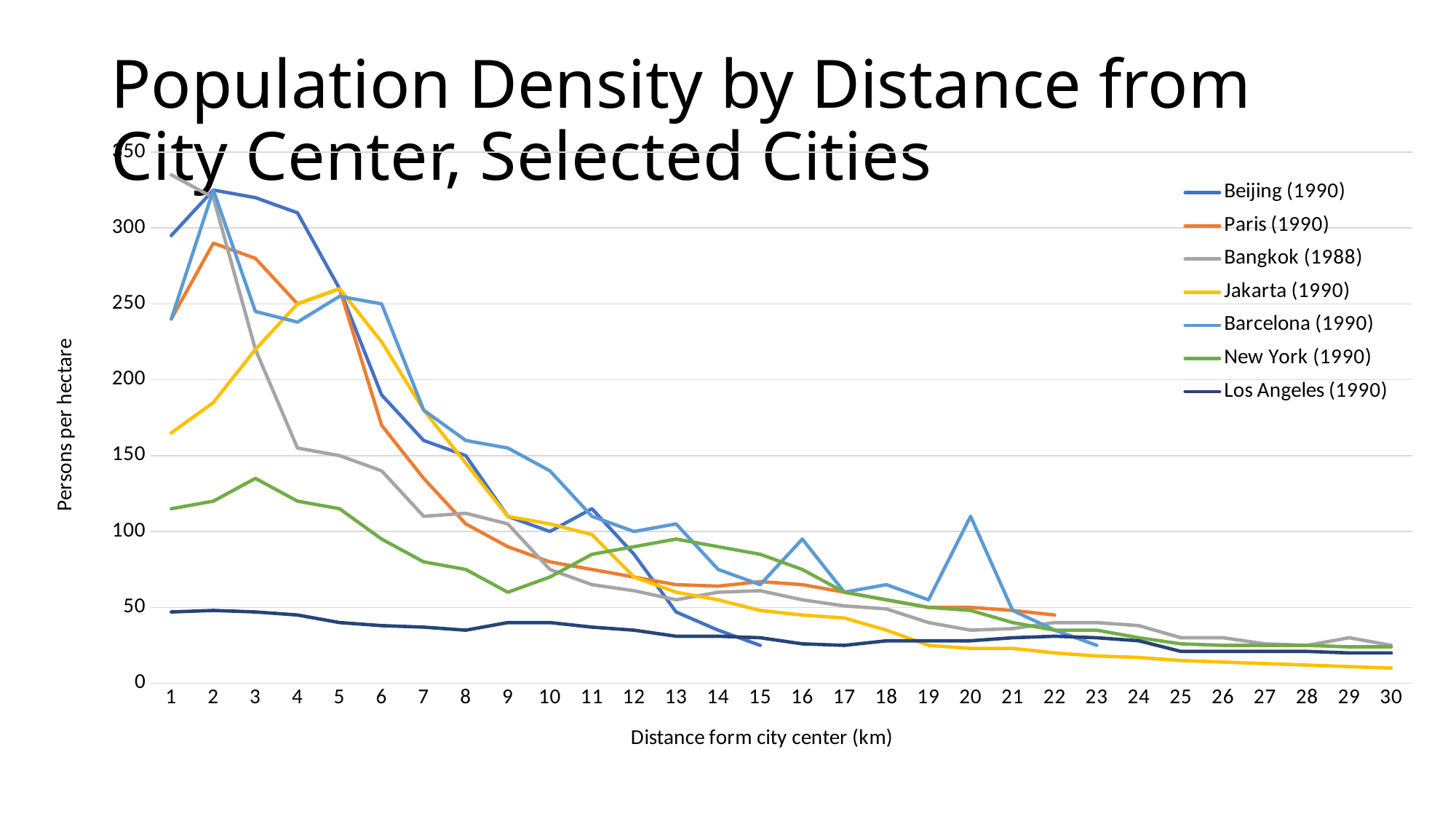
Is the value for Jakarta (1990) at 30 km greater or less than 50? less At 3 km, which is larger: Paris (1990) or Bangkok (1988)? Paris (1990) Is the value for Beijing (1990) at 4 km greater or less than 300? greater At 1 km, which series has the highest value? Bangkok (1988) Does the Los Angeles (1990) line generally rise or fall as distance from the city center increases? fall Is the value for Paris (1990) at 2 km greater or less than 300? less What is the label on the y axis? Persons per hectare What kind of chart is shown on the slide? line chart How many series does the legend list? 7 At 1 km, which series has the lowest value? Los Angeles (1990) How many distance values are shown along the x axis? 30